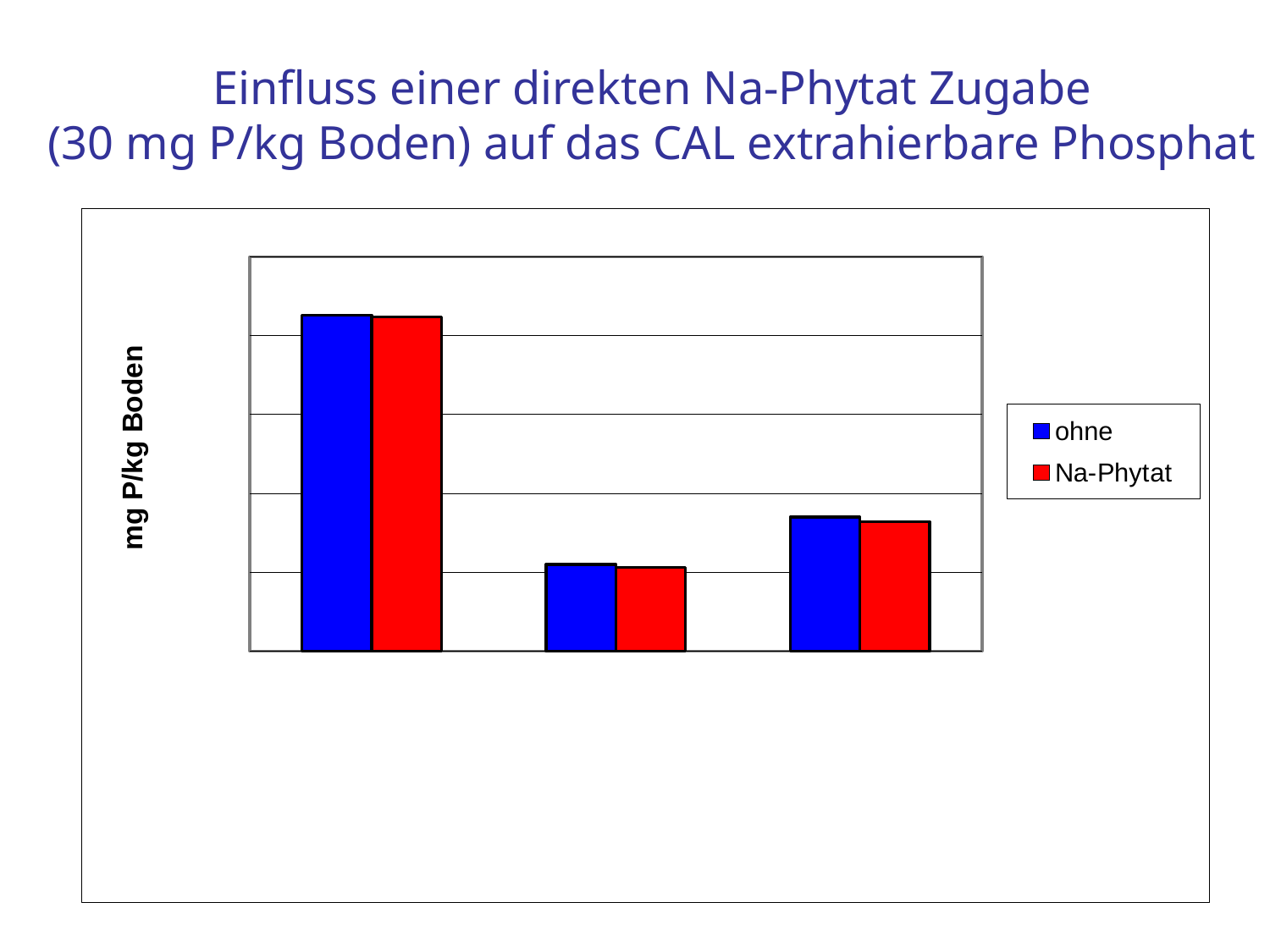
Which colour represents the 'Na-Phytat' series? red How many bars are plotted in total? 6 How many series does the legend list? 2 Is the 'Na-Phytat' bar in the second group larger or smaller than the 'Na-Phytat' bar in the third group? smaller How many groups of bars are plotted in the chart? 3 What kind of chart is shown on the slide? bar chart Which group of bars (first, second or third from the left) has the lowest values? second Is the 'ohne' bar in the first group larger or smaller than the 'ohne' bar in the third group? larger What is the label on the vertical axis? mg P/kg Boden What are the two series named in the legend? ohne, Na-Phytat Which group of bars (first, second or third from the left) has the highest values? first